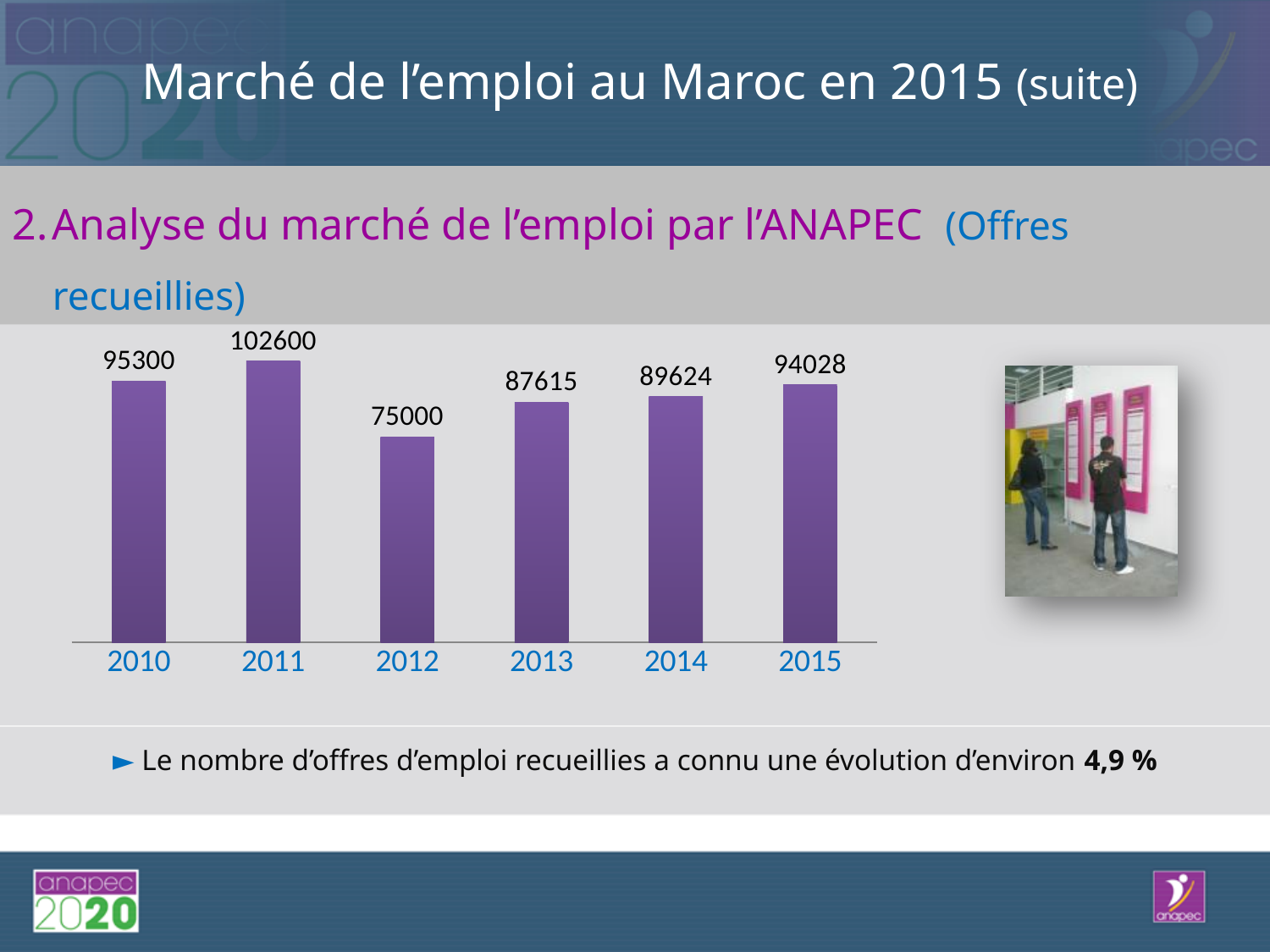
What is the value for 2010? 95300 What colour are the bars? purple What is the difference between the values for 2015 and 2014? 4404 Which year has the lowest value? 2012 What is the value for 2012? 75000 What is the difference between the values for 2011 and 2012? 27600 Which is larger, the value for 2013 or the value for 2014? 2014 Which year has the highest value? 2011 Do the values rise or fall from 2012 to 2015? rise How many years are shown on the x axis? 6 What is the value for 2015? 94028 What kind of chart is shown? bar chart